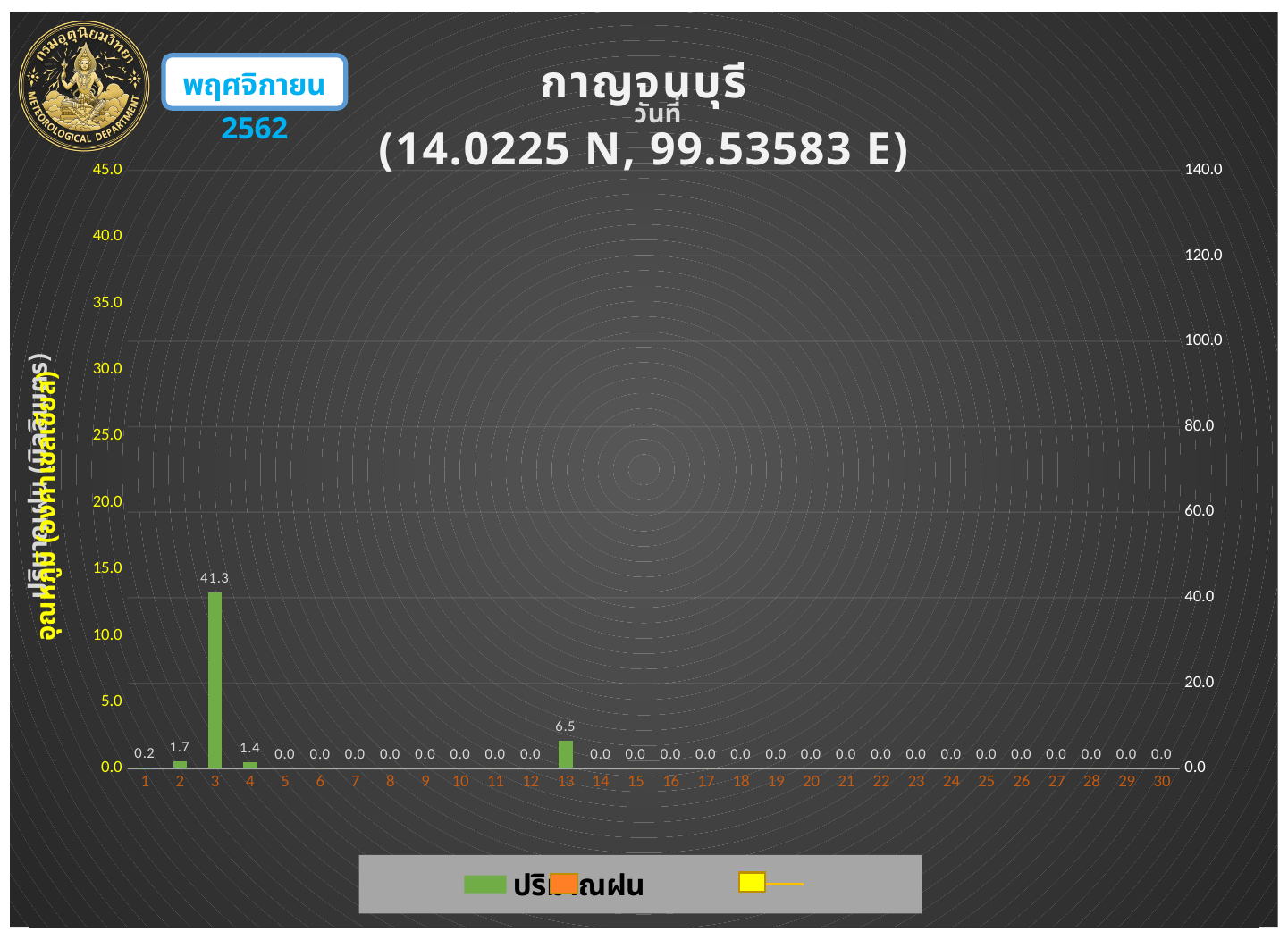
What is the rainfall value shown for day 1? 0.2 What is the rainfall value shown for day 13? 6.5 What is the difference between the rainfall values for day 3 and day 13? 34.8 Which day has the highest rainfall value? 3 What kind of chart is used to show the rainfall values? bar chart What is the rainfall value shown for day 3? 41.3 How many days are shown along the x axis? 30 Which is larger, the rainfall value for day 2 or for day 4? day 2 What is the rainfall value shown for day 4? 1.4 Is the rainfall value for day 3 greater or less than 40.0 on the right-hand axis? greater What is the rainfall value shown for day 2? 1.7 What coordinates are given in the chart title? 14.0225 N, 99.53583 E